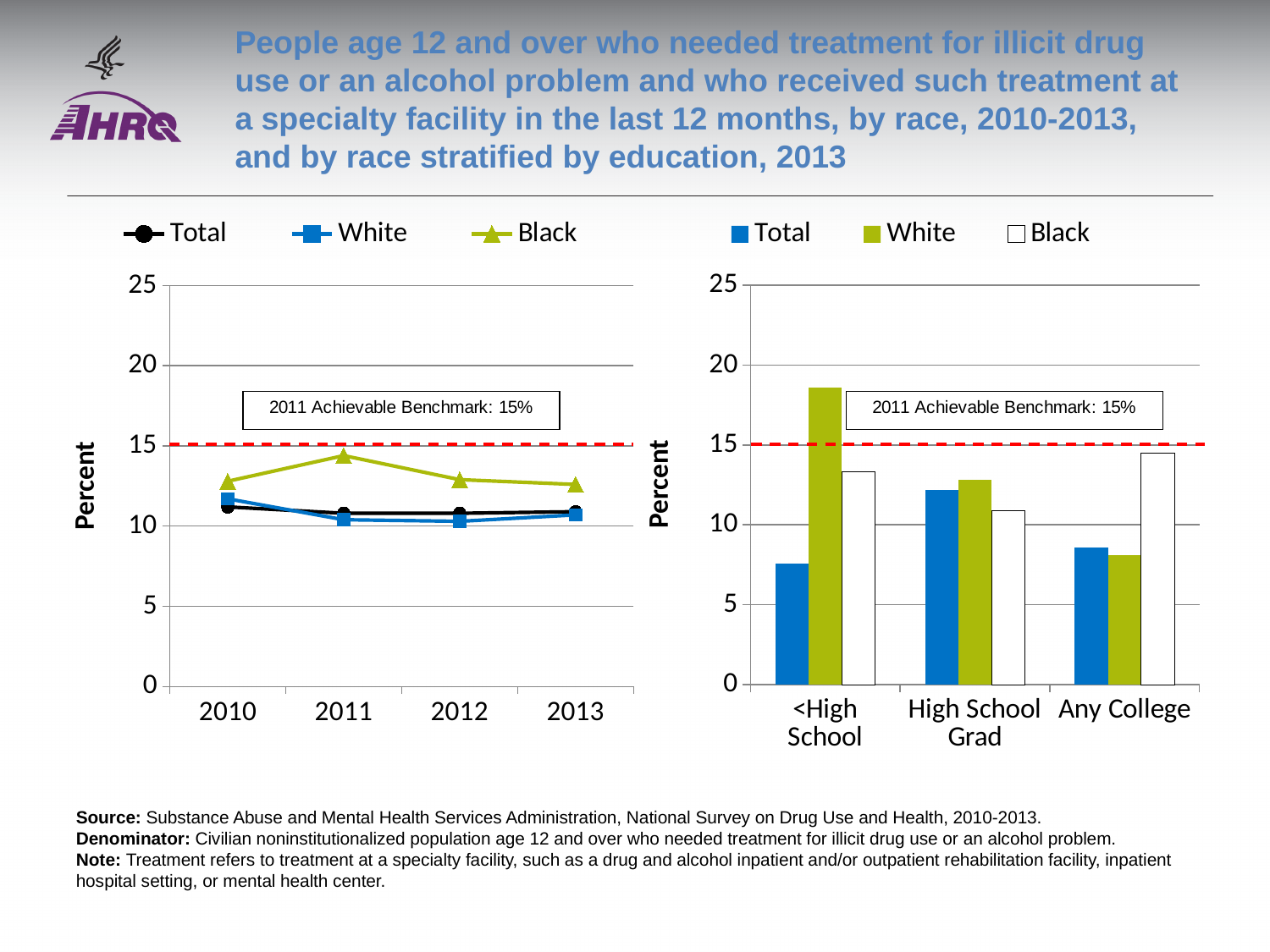
How many series does the legend of the left chart list? 3 In the right chart, is the value for White in the <High School group greater or less than 15? greater What kind of chart is the right chart showing education groups? bar chart What is the 2011 Achievable Benchmark value shown on both charts? 15% How many education categories are shown on the right chart? 3 In the right chart, which education group has the highest value for White? <High School How many years are plotted on the x axis of the left chart? 4 In the right chart, is the value for Total in the <High School group greater or less than 10? less In the left chart, which series has the highest value in 2011? Black In the left chart, is the value for Black in 2010 greater or less than 10? greater In the right chart, for the Any College group, which is larger: Black or White? Black What kind of chart is the left chart showing 2010-2013? line chart